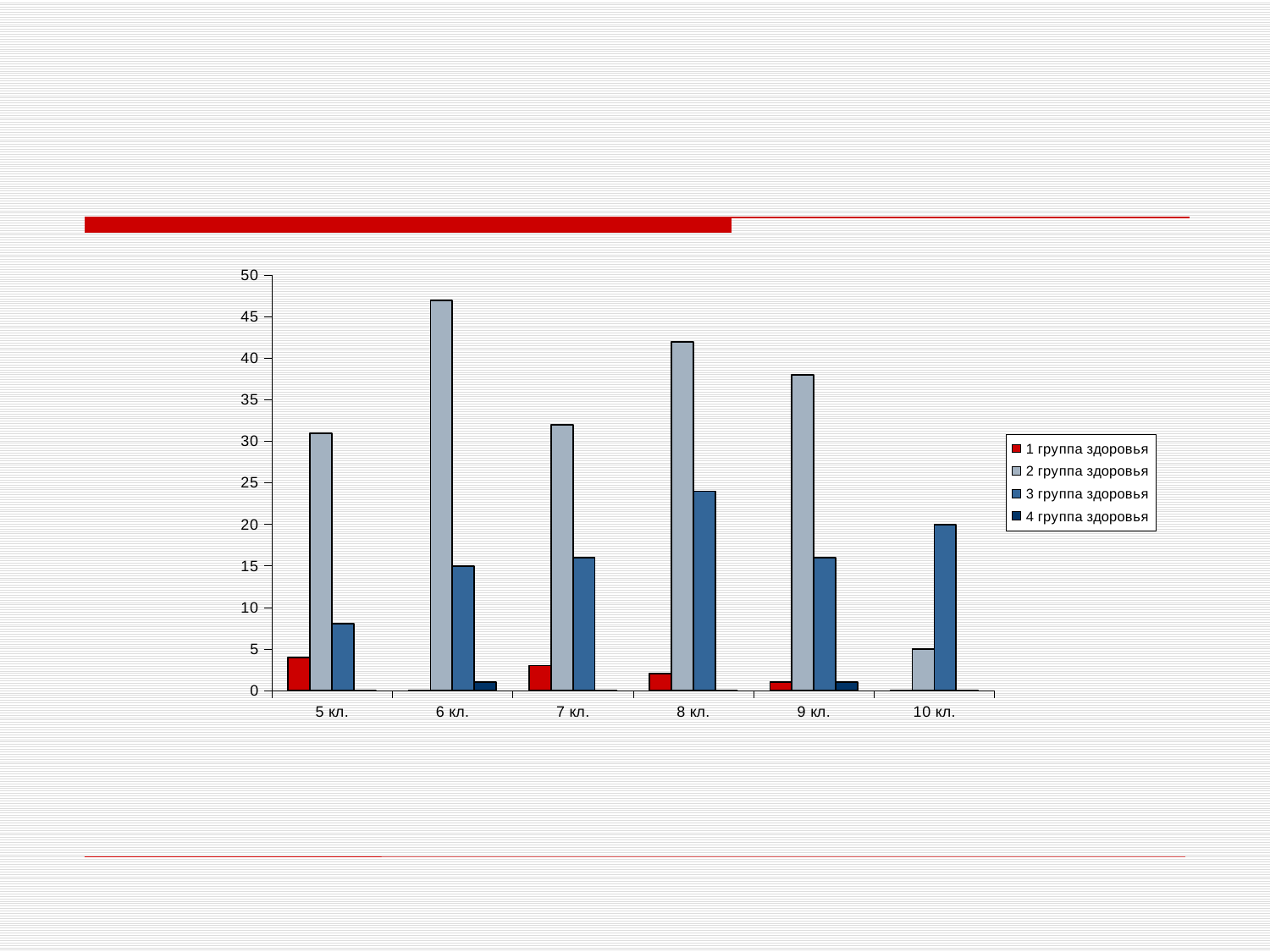
Which is larger: 3 группа здоровья in 8 кл. or 3 группа здоровья in 9 кл.? 8 кл. Is the value for 2 группа здоровья in 5 кл. greater or less than 35? less Which class has the lowest bar for 2 группа здоровья? 10 кл. How many classes (categories) are shown on the x axis? 6 Is the value for 2 группа здоровья in 6 кл. greater or less than 45? greater Which is larger: 2 группа здоровья in 9 кл. or 2 группа здоровья in 7 кл.? 9 кл. Which class has the highest bar for 2 группа здоровья? 6 кл. Is the value for 3 группа здоровья in 8 кл. greater or less than 20? greater What kind of chart is shown on the slide? bar chart What colour is the bar for 1 группа здоровья in the legend? red Which class has the highest bar for 3 группа здоровья? 8 кл. How many series does the legend list? 4